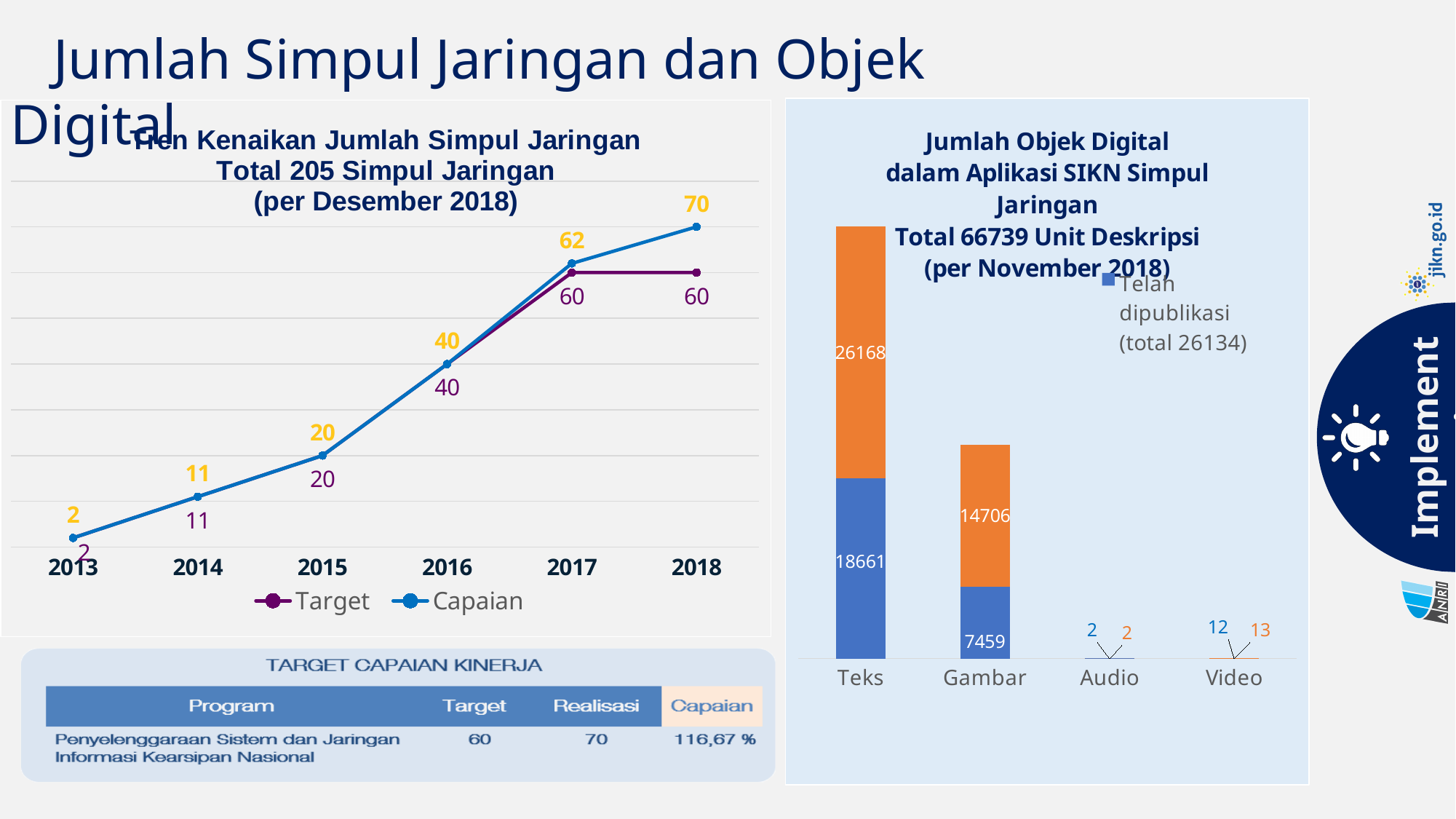
In the chart 'Tren Kenaikan Jumlah Simpul Jaringan', what is the Target value for 2017? 60 How many series does the legend of the chart 'Tren Kenaikan Jumlah Simpul Jaringan' list? 2 In the chart 'Jumlah Objek Digital dalam Aplikasi SIKN Simpul Jaringan', which category has the highest total? Teks What kind of chart is 'Tren Kenaikan Jumlah Simpul Jaringan'? Line chart In the chart 'Jumlah Objek Digital dalam Aplikasi SIKN Simpul Jaringan', what is the 'Telah dipublikasi' value for Teks? 18661 In the chart 'Tren Kenaikan Jumlah Simpul Jaringan', does the Capaian series rise or fall from 2013 to 2018? Rise In the chart 'Jumlah Objek Digital dalam Aplikasi SIKN Simpul Jaringan', what is the total of the stacked bar for Teks? 44829 How many years are shown on the x axis of the chart 'Tren Kenaikan Jumlah Simpul Jaringan'? 6 In the chart 'Tren Kenaikan Jumlah Simpul Jaringan', what is the difference between the Capaian and Target values in 2018? 10 In the chart 'Jumlah Objek Digital dalam Aplikasi SIKN Simpul Jaringan', what is the total of the stacked bar for Gambar? 22165 In the chart 'Tren Kenaikan Jumlah Simpul Jaringan', what is the Capaian value for 2018? 70 How many categories are shown on the x axis of the chart 'Jumlah Objek Digital dalam Aplikasi SIKN Simpul Jaringan'? 4